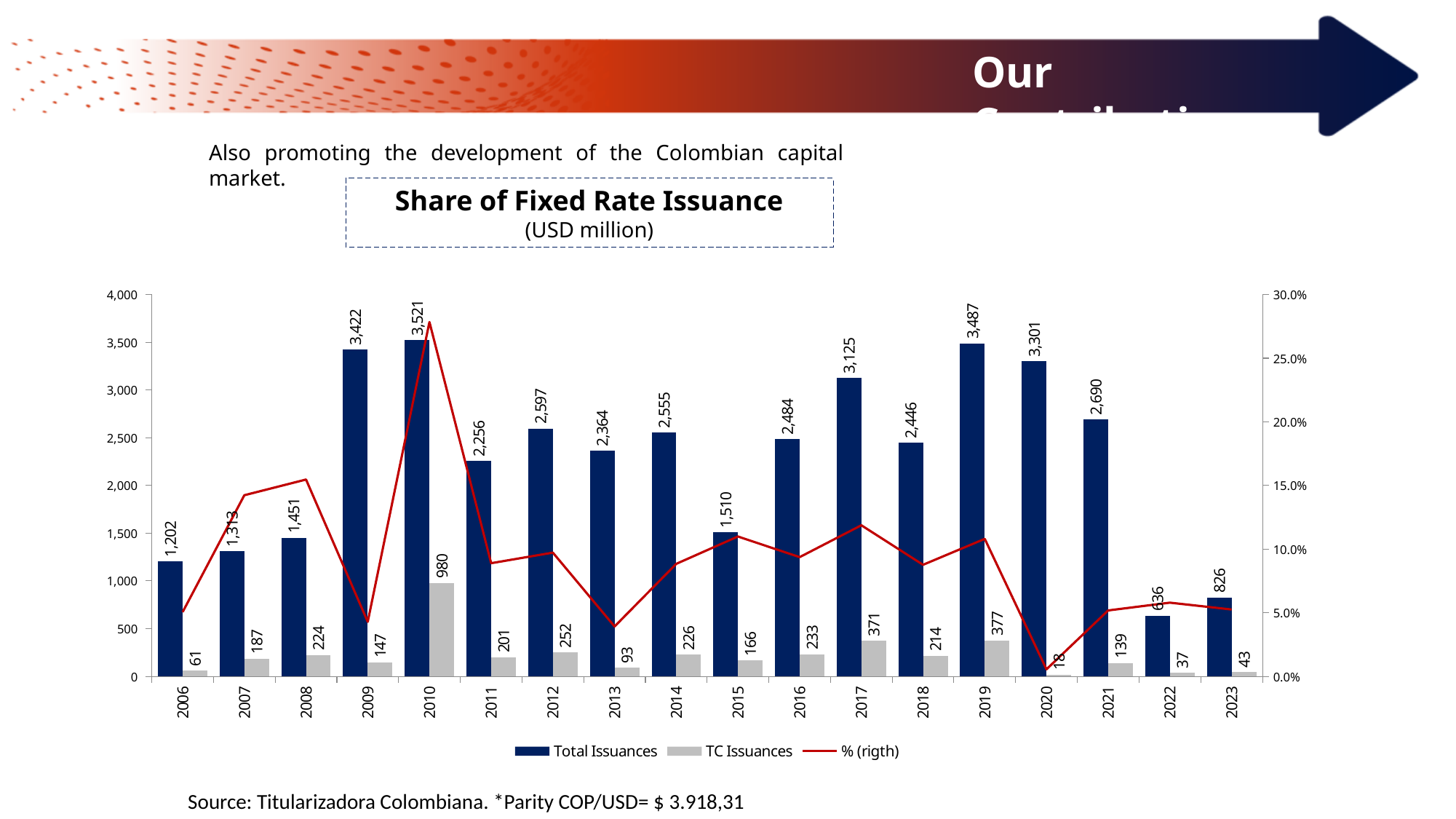
Which year has the highest Total Issuances? 2010 Which is larger, Total Issuances in 2017 or in 2019? 2019 What is the value of Total Issuances for 2022? 636 Which year has the highest TC Issuances? 2010 Is the % (rigth) value for 2010 greater or less than 25.0%? greater How many years are shown on the x axis? 18 What is the value of TC Issuances for 2017? 371 How many series does the legend list? 3 Which year has the lowest Total Issuances? 2022 What is the value of Total Issuances for 2010? 3,521 What is the title of the chart? Share of Fixed Rate Issuance What is the difference between Total Issuances and TC Issuances in 2010? 2,541